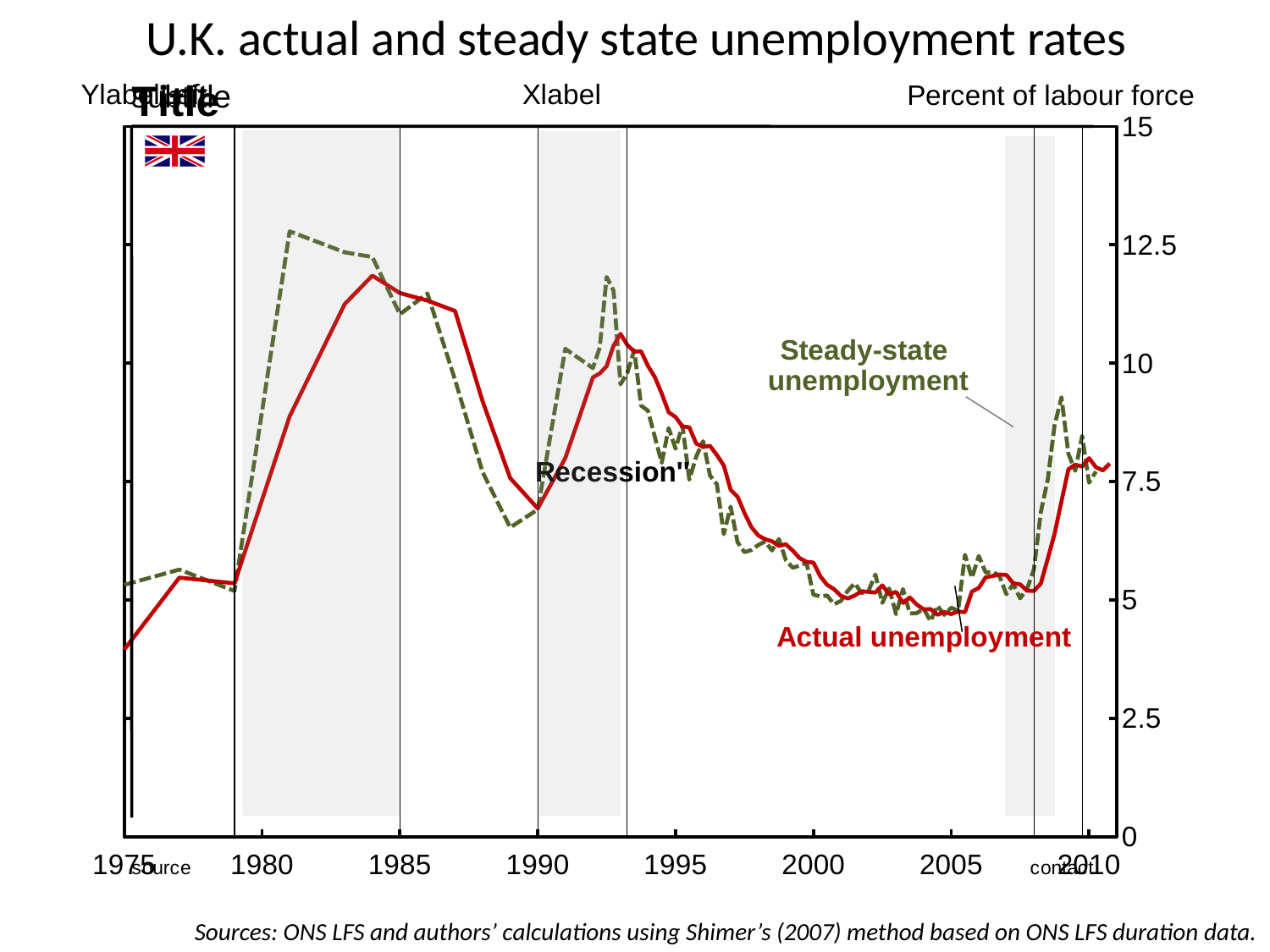
Is the value of actual unemployment in 2005 greater or less than 7.5? less In 1981, which series is higher: actual unemployment or steady-state unemployment? Steady-state unemployment In which year does actual unemployment reach its highest point? 1984 Is the value of actual unemployment in 1984 greater or less than 10? greater What kind of chart is shown on the slide? line chart How many data series are plotted on the chart? 2 Is the value of actual unemployment in 1975 greater or less than 5? less Does actual unemployment rise or fall between 1993 and 2004? fall In 1989, which series is higher: actual unemployment or steady-state unemployment? Actual unemployment What unit is given for the vertical axis? Percent of labour force What is the title of the chart? U.K. actual and steady state unemployment rates